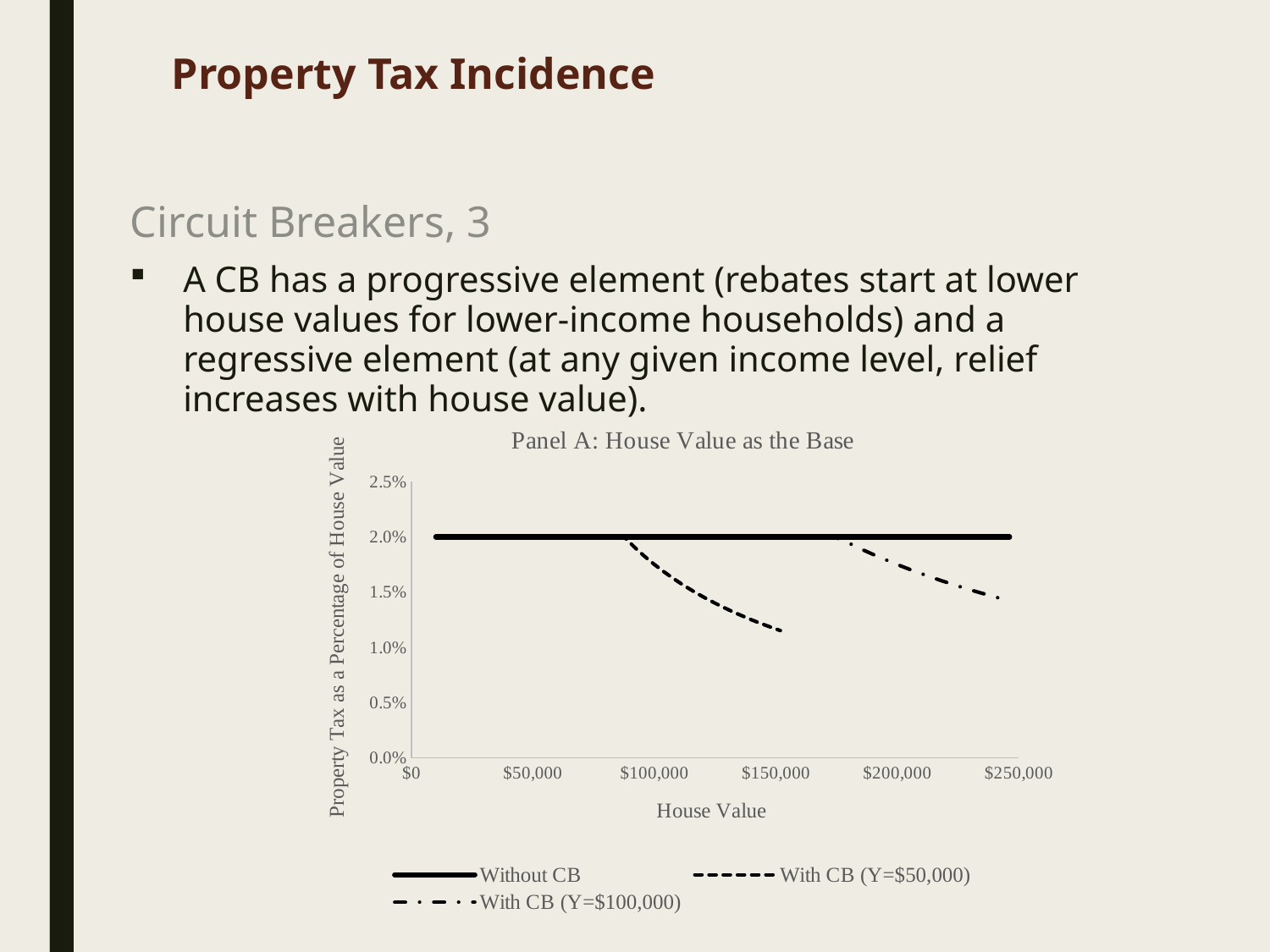
What is the label of the x axis? House Value Does the Without CB line rise, fall, or stay flat as house value increases? stays flat What is the title of the chart? Panel A: House Value as the Base Is the value for With CB (Y=$100,000) at $250,000 greater or less than 2.0%? less How many series does the legend list? 3 Is the value for With CB (Y=$50,000) at $150,000 greater or less than 1.5%? less At a house value of $200,000, which is larger: Without CB or With CB (Y=$100,000)? Without CB What kind of chart is shown on the slide? line chart Does the With CB (Y=$50,000) line rise or fall as house value increases beyond $100,000? fall Which series reaches the lowest property tax percentage on the chart? With CB (Y=$50,000) At a house value of $150,000, which is larger: Without CB or With CB (Y=$50,000)? Without CB What is the property tax as a percentage of house value for the Without CB series? 2.0%